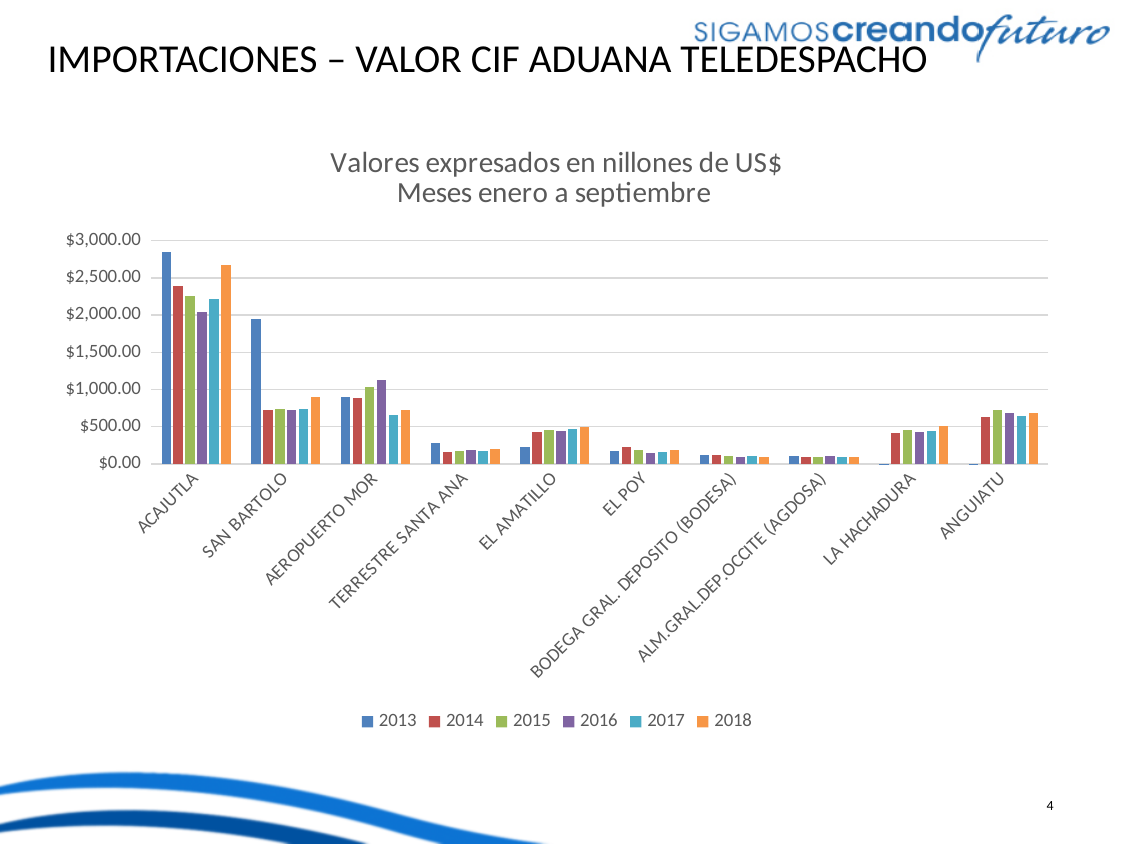
What kind of chart is shown on the slide? Bar chart For SAN BARTOLO, does the value rise or fall from 2013 to 2014? Fall Which year is shown in orange in the legend? 2018 How many categories (aduanas) are shown on the x axis? 10 Which is larger for ACAJUTLA: the 2013 value or the 2018 value? 2013 For AEROPUERTO MOR, which year has the highest value? 2016 How many series does the legend list? 6 Is the 2013 value for SAN BARTOLO greater or less than $2,000.00? less Which category has the highest value for 2013? ACAJUTLA Is the 2014 value for EL POY greater or less than $500.00? less For ACAJUTLA, which year has the highest value? 2013 Is the 2013 value for ACAJUTLA greater or less than $2,500.00? greater